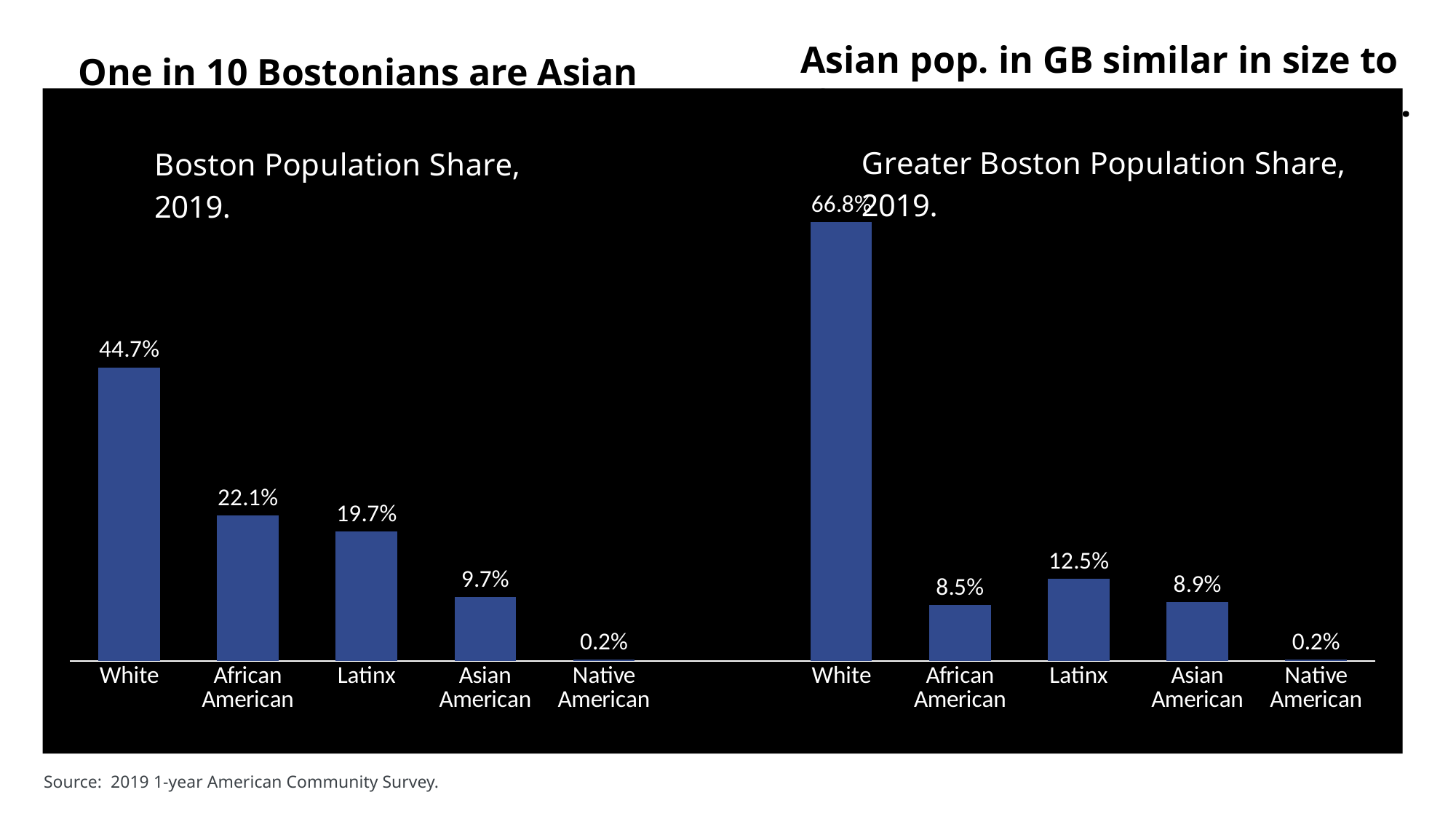
What type of chart is the Greater Boston Population Share, 2019 chart? Bar chart In the Boston Population Share, 2019 chart, what is the difference between the White and African American values? 22.6% In the Boston Population Share, 2019 chart, which is larger, the value for African American or the value for Latinx? African American In the Greater Boston Population Share, 2019 chart, which is larger, the value for African American or the value for Asian American? Asian American In the Greater Boston Population Share, 2019 chart, what is the difference between the Latinx and Asian American values? 3.6% In the Greater Boston Population Share, 2019 chart, what is the value for Latinx? 12.5% In the Greater Boston Population Share, 2019 chart, what is the value for White? 66.8% In the Boston Population Share, 2019 chart, which category has the highest value? White How many categories are shown in the Boston Population Share, 2019 chart? 5 In the Greater Boston Population Share, 2019 chart, which category has the lowest value? Native American In the Boston Population Share, 2019 chart, what is the value for Asian American? 9.7% What is the source cited at the bottom of the slide? 2019 1-year American Community Survey.